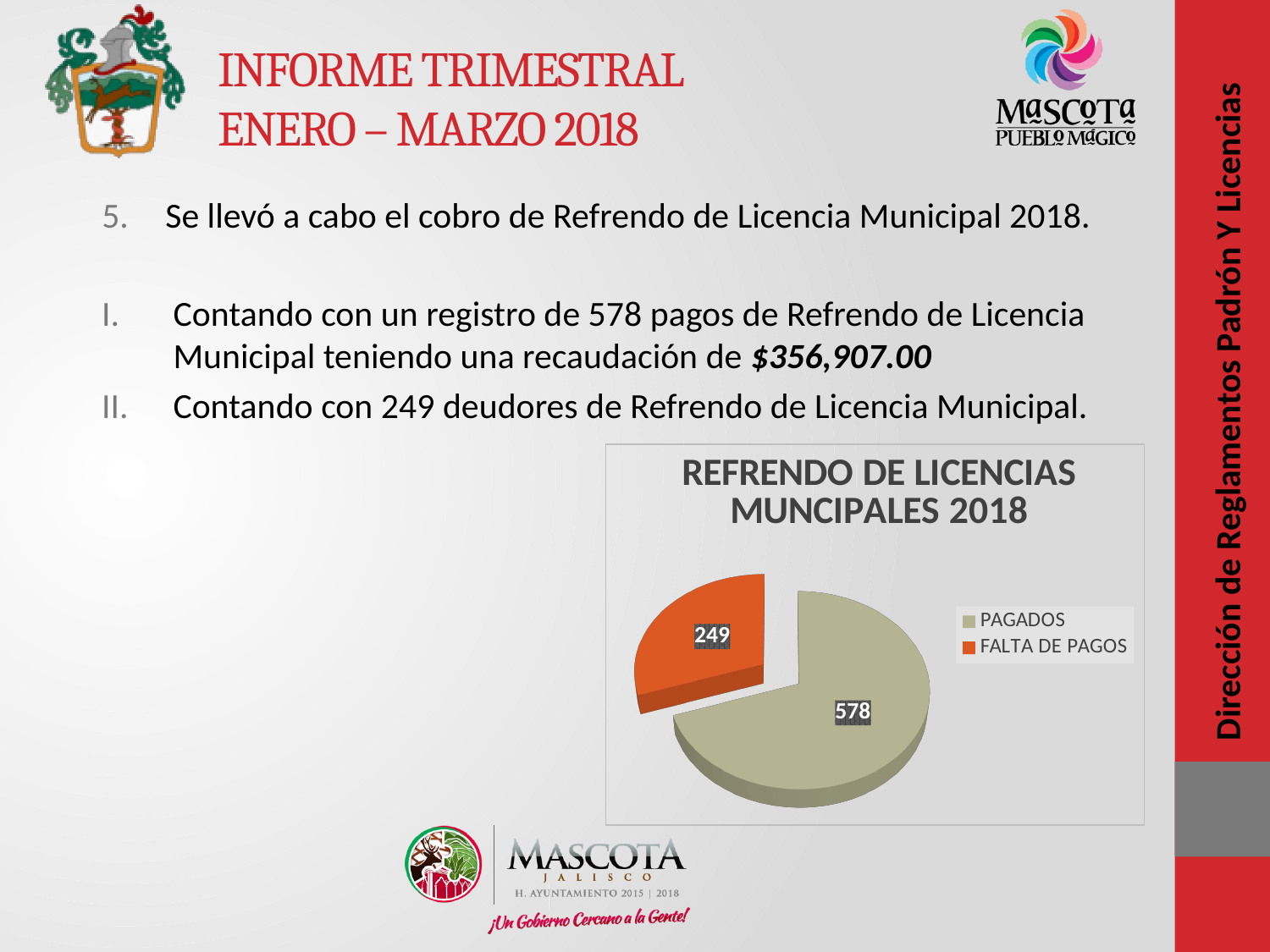
What is the difference between the PAGADOS and FALTA DE PAGOS values? 329 Which is larger, PAGADOS or FALTA DE PAGOS? PAGADOS What is the total of all slices in the pie chart? 827 What colour is the FALTA DE PAGOS slice in the pie chart? Orange What is the value for PAGADOS in the pie chart? 578 What is the title of the chart? REFRENDO DE LICENCIAS MUNCIPALES 2018 What type of chart is shown on the slide? Pie chart How many categories does the pie chart show? 2 Which category has the smallest slice in the pie chart? FALTA DE PAGOS Which category has the largest slice in the pie chart? PAGADOS What is the value for FALTA DE PAGOS in the pie chart? 249